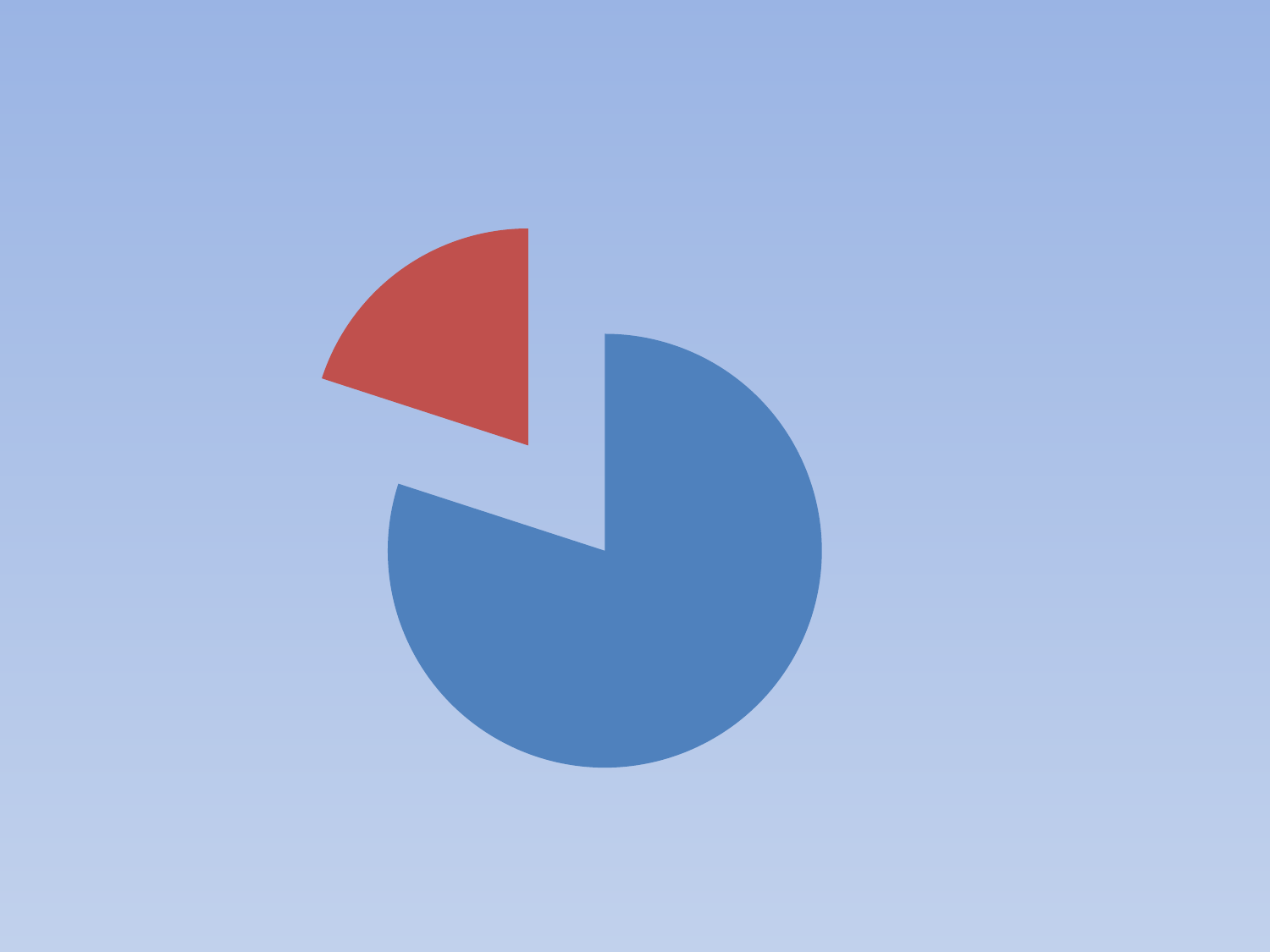
Does the pie chart have a legend? No Which slice of the pie chart is pulled out (exploded) from the rest of the pie? the red slice How many slices does the pie chart have? 2 Which slice of the pie chart is larger, the blue one or the red one? the blue one What kind of chart is shown on the slide? pie chart